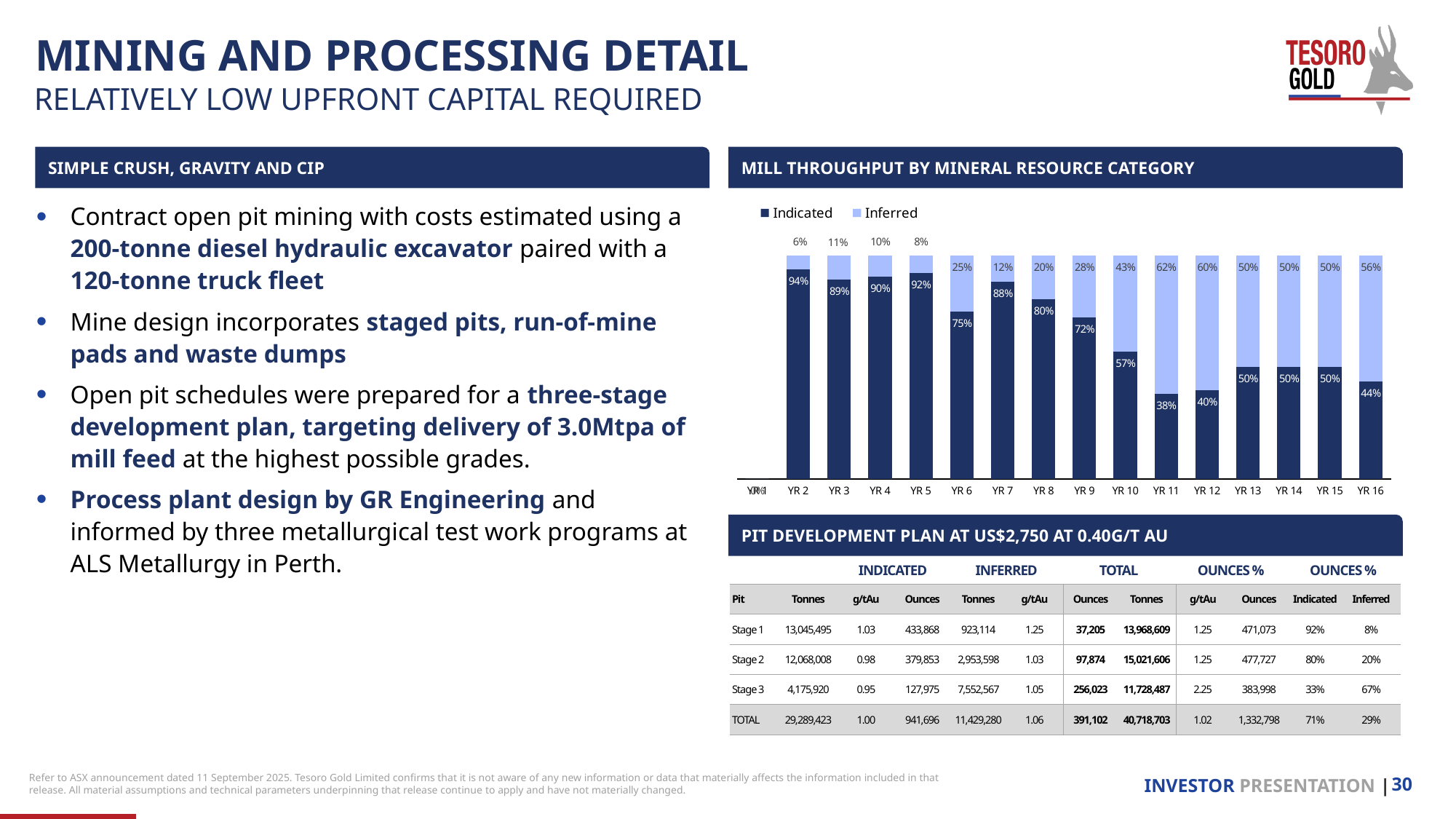
In the mill throughput chart, which year has the highest Inferred share? YR 11 What are the two legend entries of the mill throughput chart? Indicated and Inferred In the mill throughput chart, which year has the lowest Indicated share? YR 11 In the mill throughput chart, does the Indicated share generally rise or fall from YR 2 to YR 16? fall In the mill throughput chart, what is the Indicated share for YR 16? 44% In the mill throughput chart, is the Indicated share larger in YR 6 or in YR 7? YR 7 In the mill throughput chart, what is the difference between the Indicated share in YR 2 and in YR 11? 56% What kind of chart is shown under 'Mill Throughput by Mineral Resource Category'? stacked bar chart How many series does the legend of the mill throughput chart list? 2 In the mill throughput chart, which year has the highest Indicated share? YR 2 In the mill throughput chart, what is the Inferred share for YR 10? 43% In the mill throughput chart, what is the Indicated share for YR 2? 94%